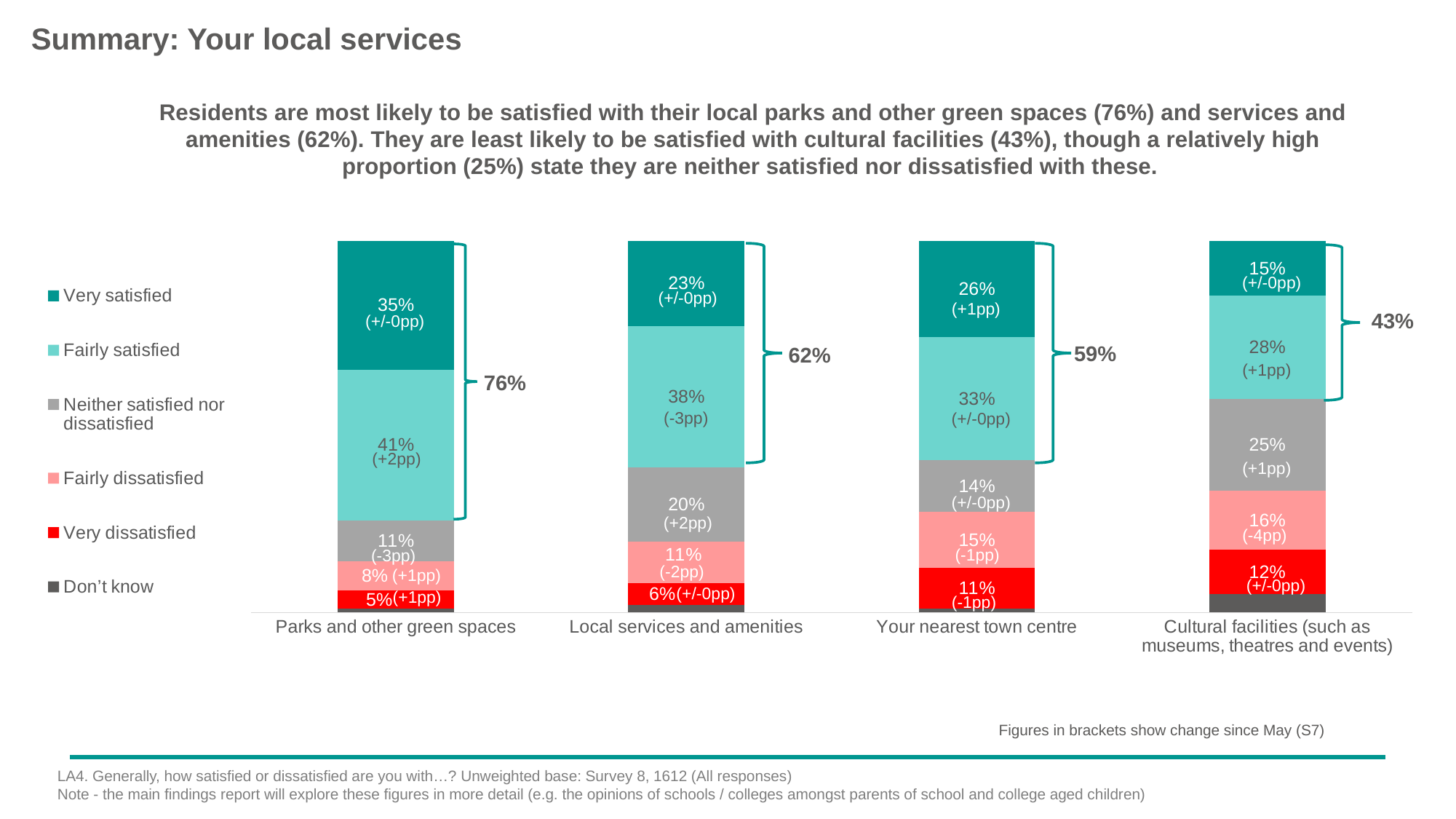
What type of chart is shown on the slide? Stacked bar chart Which service has the lowest combined satisfied percentage shown by the bracket? Cultural facilities (such as museums, theatres and events) What is the difference between the very satisfied percentage for parks and other green spaces and for cultural facilities? 20 percentage points What change since May is shown in brackets for the fairly satisfied segment of parks and other green spaces? +2pp What percentage of residents are neither satisfied nor dissatisfied with cultural facilities? 25% Which has a larger fairly dissatisfied percentage: your nearest town centre or local services and amenities? Your nearest town centre What percentage of residents are very satisfied with parks and other green spaces? 35% How many services are shown on the x axis of the chart? 4 What percentage of residents are fairly satisfied with local services and amenities? 38% How many response categories does the legend list? 6 Which service has the highest combined satisfied percentage shown by the bracket? Parks and other green spaces What percentage of residents are very dissatisfied with their nearest town centre? 11%